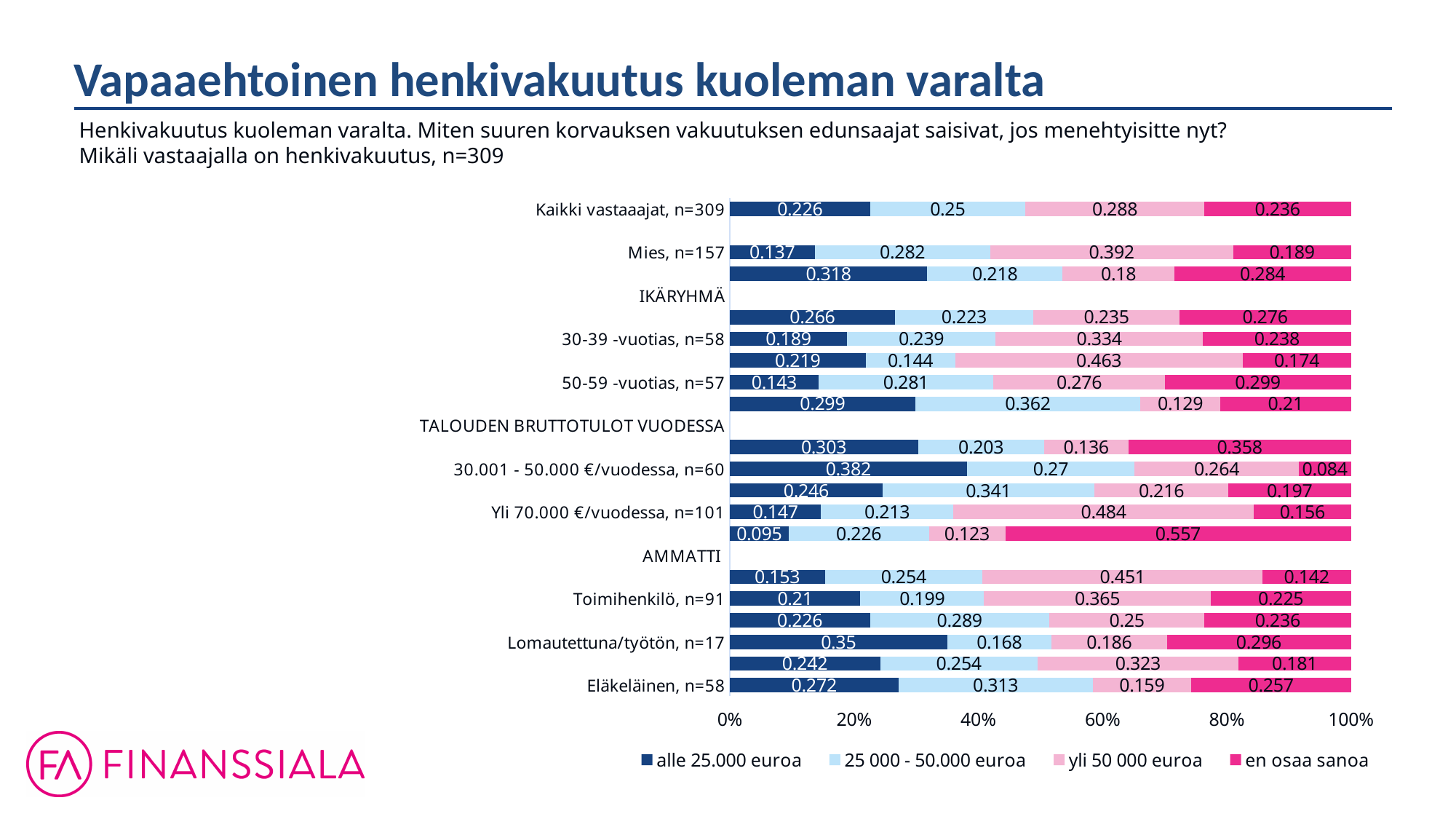
What kind of chart is shown on the slide? Stacked bar chart What is the value for '25 000 - 50.000 euroa' for Eläkeläinen, n=58? 0.313 For Lomautettuna/työtön, n=17, which series has the smallest share? 25 000 - 50.000 euroa How many series does the legend list? 4 What is the value for 'en osaa sanoa' for 50-59 -vuotias, n=57? 0.299 What is the value for 'alle 25.000 euroa' for Kaikki vastaaajat, n=309? 0.226 For Yli 70.000 €/vuodessa, n=101, which series has the largest share? yli 50 000 euroa What is the value for 'yli 50 000 euroa' for Mies, n=157? 0.392 What is the difference between 'yli 50 000 euroa' and 'alle 25.000 euroa' for Mies, n=157? 0.255 Which is larger for Toimihenkilö, n=91: 'alle 25.000 euroa' or 'yli 50 000 euroa'? yli 50 000 euroa What is the value for 'alle 25.000 euroa' for 30.001 - 50.000 €/vuodessa, n=60? 0.382 What is the last entry in the chart legend? en osaa sanoa